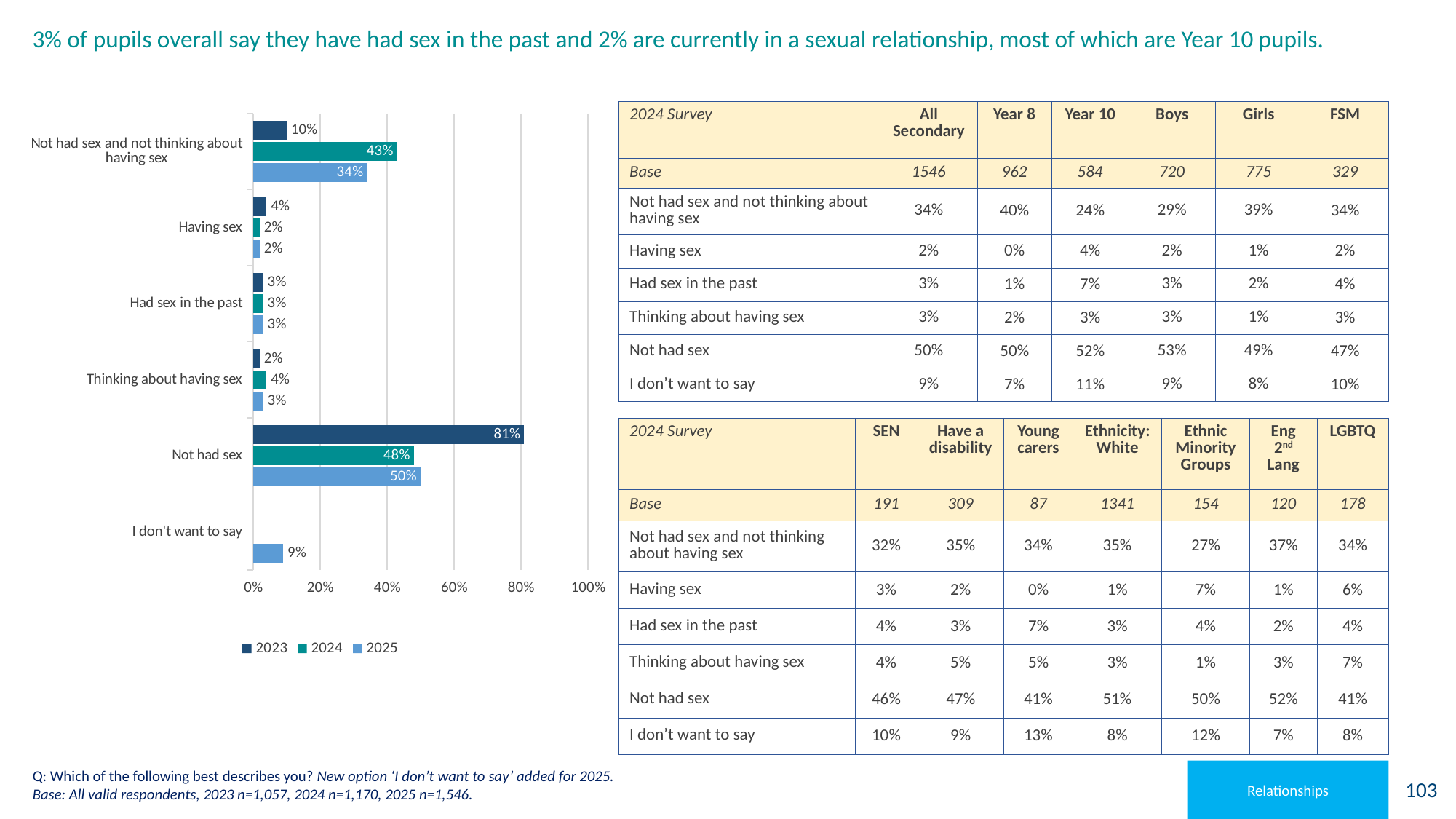
What is the 2025 value for 'Having sex'? 2% What is the 2025 value for 'I don't want to say'? 9% Which series is shown in the darkest blue colour in the legend? 2023 How many series does the chart legend list? 3 What is the 2024 value for 'Not had sex and not thinking about having sex'? 43% How many categories are shown on the chart's vertical axis? 6 Which category has the highest 2025 value? Not had sex Is the 2023 value for 'Not had sex' greater or less than 80%? greater What kind of chart is shown on the slide? bar chart What is the 2023 value for 'Not had sex'? 81% Which is larger for 'Thinking about having sex': the 2024 value or the 2023 value? 2024 What is the difference between the 2023 and 2025 values for 'Not had sex'? 31%